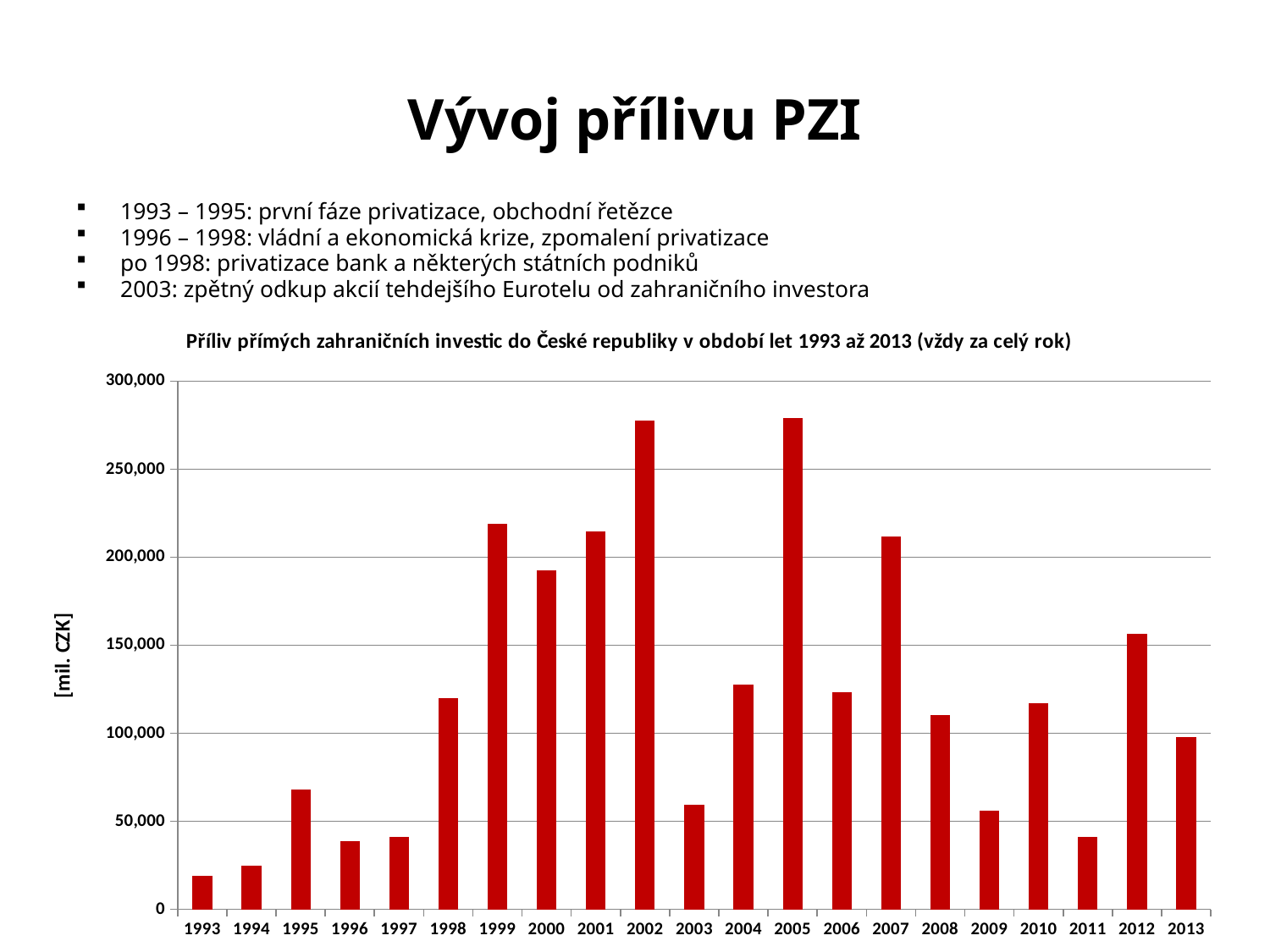
What unit is shown on the y-axis label of the chart? [mil. CZK] Which year has the lowest value in the chart? 1993 What is the title of the chart? Příliv přímých zahraničních investic do České republiky v období let 1993 až 2013 (vždy za celý rok) Is the value for 2012 greater or less than 150,000? greater Is the value for 1998 greater or less than 150,000? less Which year has the larger value, 1999 or 2000? 1999 How many years (bars) are plotted in the chart? 21 Which year has the larger value, 2007 or 2012? 2007 What kind of chart is shown on the slide? bar chart Do the values rise or fall from 2007 to 2009? fall Is the value for 2003 greater or less than 100,000? less